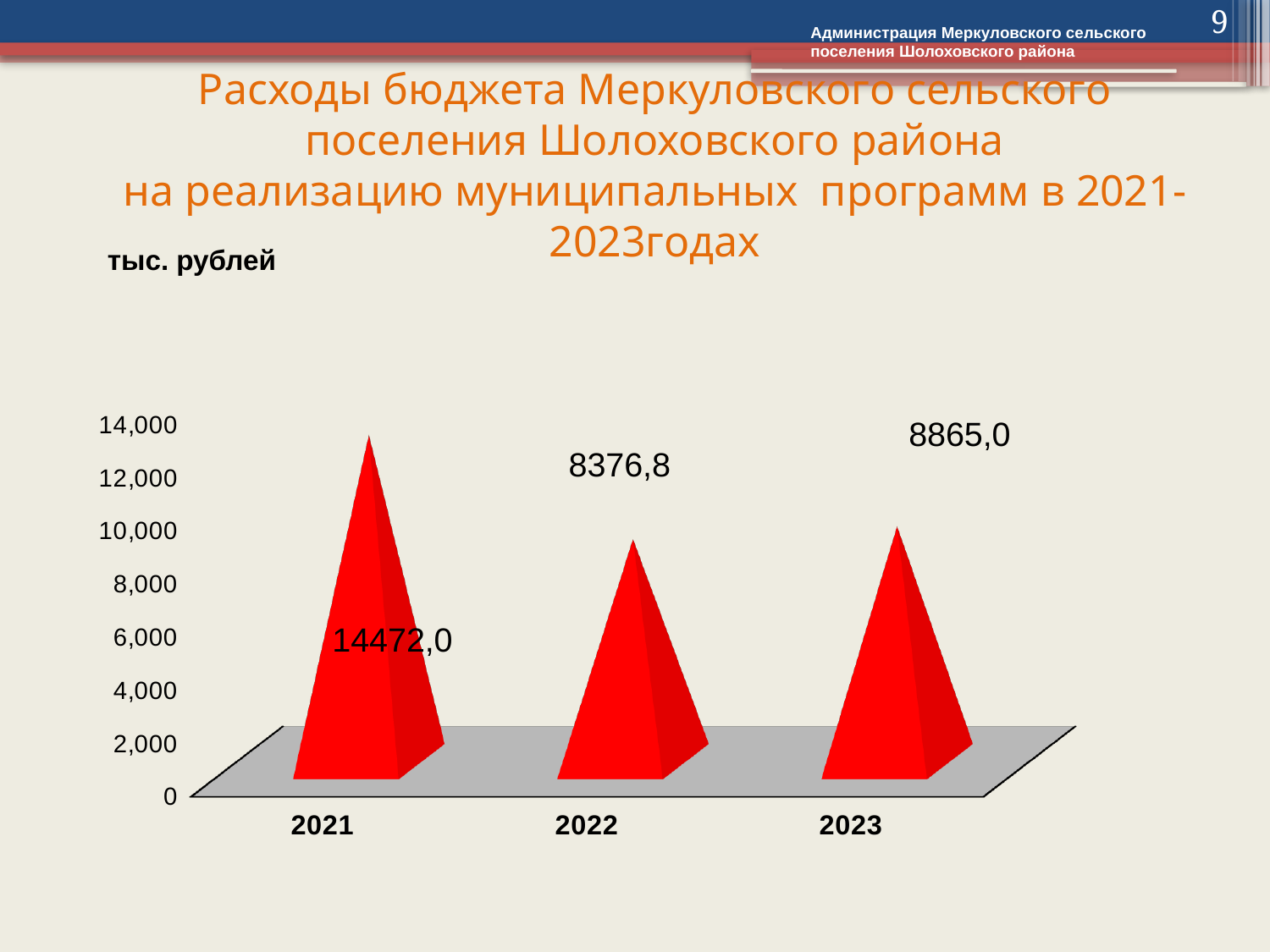
Which year has the lowest value? 2022 How many years are shown on the chart? 3 What is the difference between the values for 2023 and 2022? 488,2 What unit of measurement is indicated for the chart values? тыс. рублей What is the value shown for 2023? 8865,0 Which is larger, the value for 2021 or the value for 2023? 2021 Which year has the highest value? 2021 What is the difference between the values for 2021 and 2022? 6095,2 What is the value shown for 2021? 14472,0 What is the value shown for 2022? 8376,8 Is the value for 2022 greater or less than 10,000? less What kind of chart is shown on the slide? bar chart